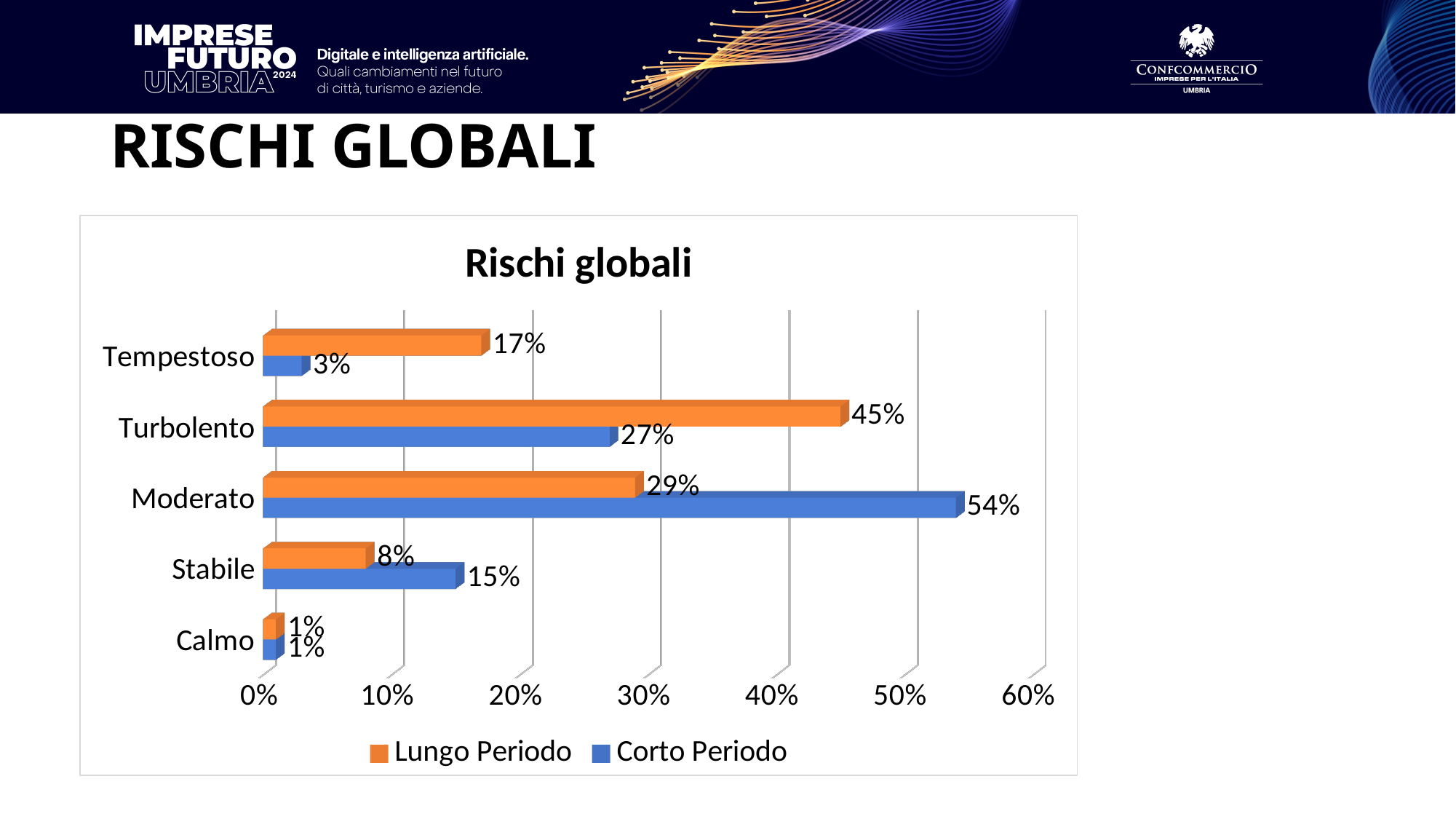
What is the Corto Periodo value for Moderato? 54% How many series does the legend list? 2 Which category has the highest Corto Periodo value? Moderato What is the difference between the Lungo Periodo and Corto Periodo values for Turbolento? 18% How many categories are shown on the chart? 5 What is the Corto Periodo value for Stabile? 15% What is the Lungo Periodo value for Turbolento? 45% What kind of chart is shown on the slide? Bar chart For Stabile, which is larger: the Lungo Periodo value or the Corto Periodo value? Corto Periodo Which category has the highest Lungo Periodo value? Turbolento What is the Lungo Periodo value for Tempestoso? 17% What is the difference between the Corto Periodo and Lungo Periodo values for Moderato? 25%